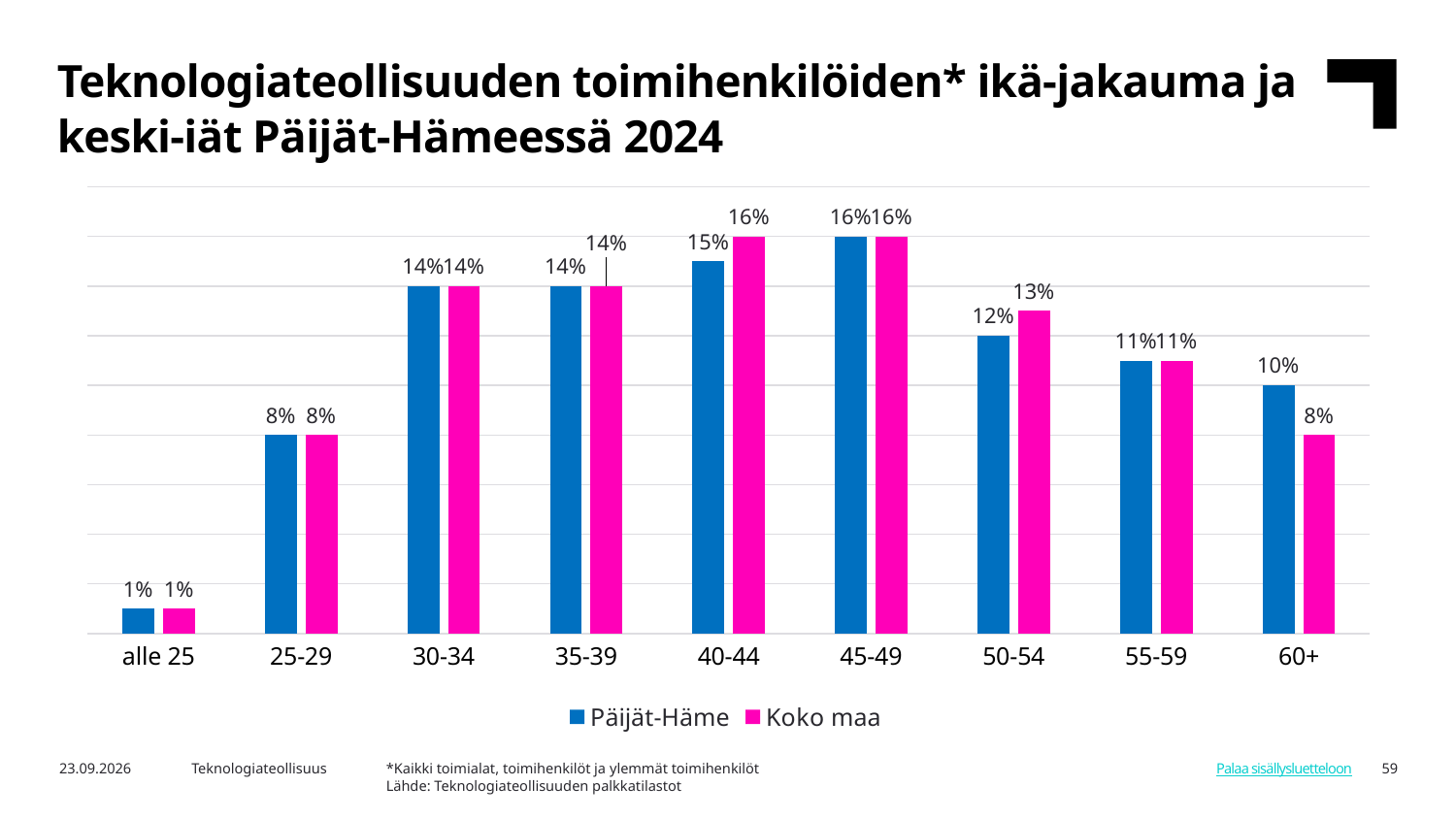
How many age groups are shown on the x axis? 9 Do the Päijät-Häme values rise or fall from the 45-49 age group to the 60+ age group? Fall What is the difference between Päijät-Häme and Koko maa in the 60+ age group? 2% What kind of chart is shown on the slide? Bar chart Which age group has the lowest value for Koko maa? alle 25 In the 40-44 age group, which series has the larger value, Päijät-Häme or Koko maa? Koko maa What is the value for Koko maa in the 50-54 age group? 13% Which colour represents the Koko maa series? Pink What is the value for Päijät-Häme in the 60+ age group? 10% How many series does the legend list? 2 What is the value for Päijät-Häme in the 40-44 age group? 15% Which age group has the highest value for Päijät-Häme? 45-49